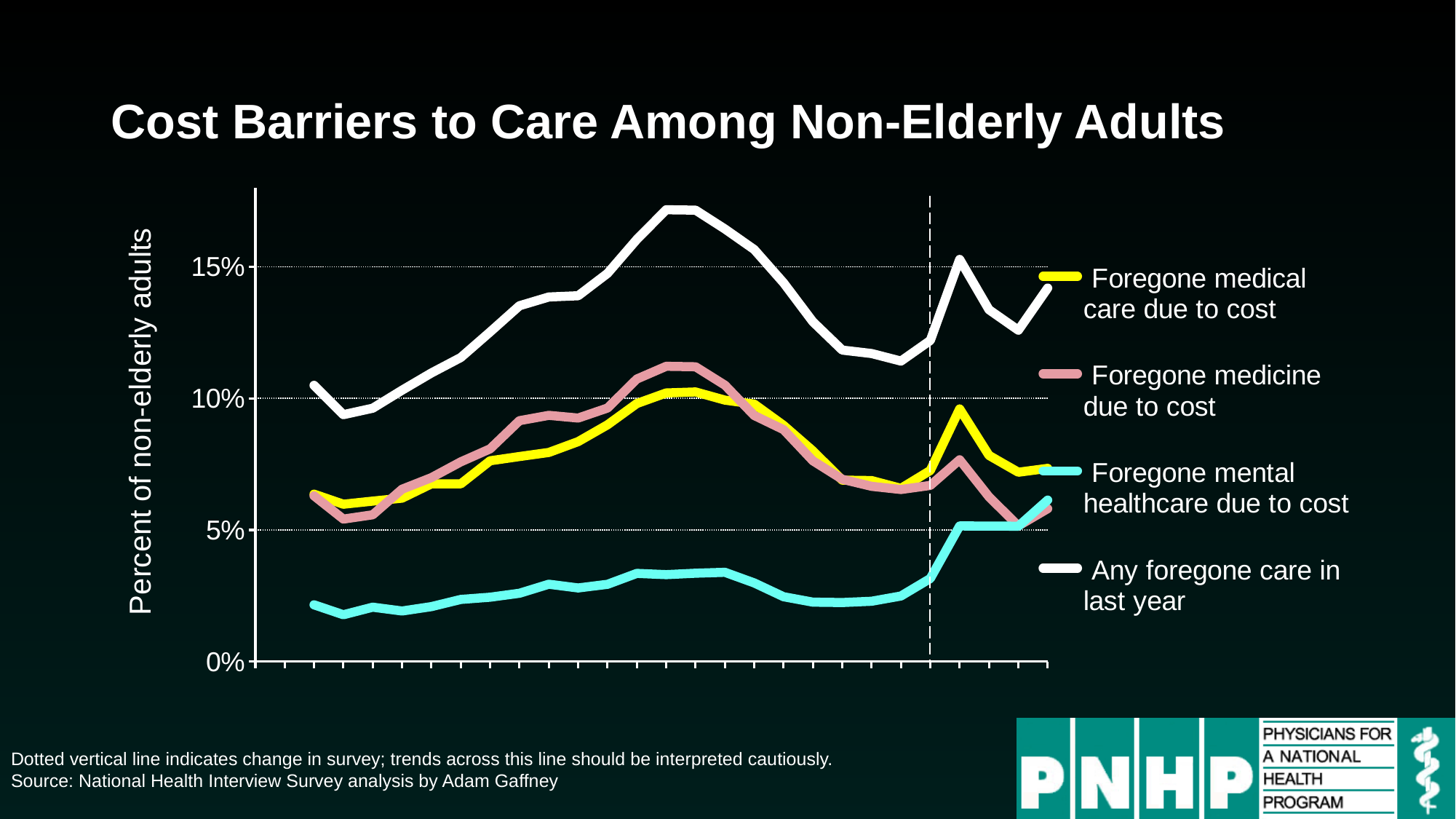
What colour is the line for Foregone medical care due to cost? yellow Is the peak value of the Foregone mental healthcare due to cost line greater or less than 10%? less Is the peak value of the Foregone medicine due to cost line greater or less than 10%? greater Does the Foregone mental healthcare due to cost line end higher or lower than it starts? higher What is the title of the chart? Cost Barriers to Care Among Non-Elderly Adults Which series has the highest values throughout the chart? Any foregone care in last year Is the peak value of the Foregone medical care due to cost line greater or less than 15%? less Which series has the lowest values throughout the chart? Foregone mental healthcare due to cost At their peaks, which is higher: Foregone medicine due to cost or Foregone medical care due to cost? Foregone medicine due to cost How many series does the legend list? 4 What kind of chart is shown on the slide? line chart